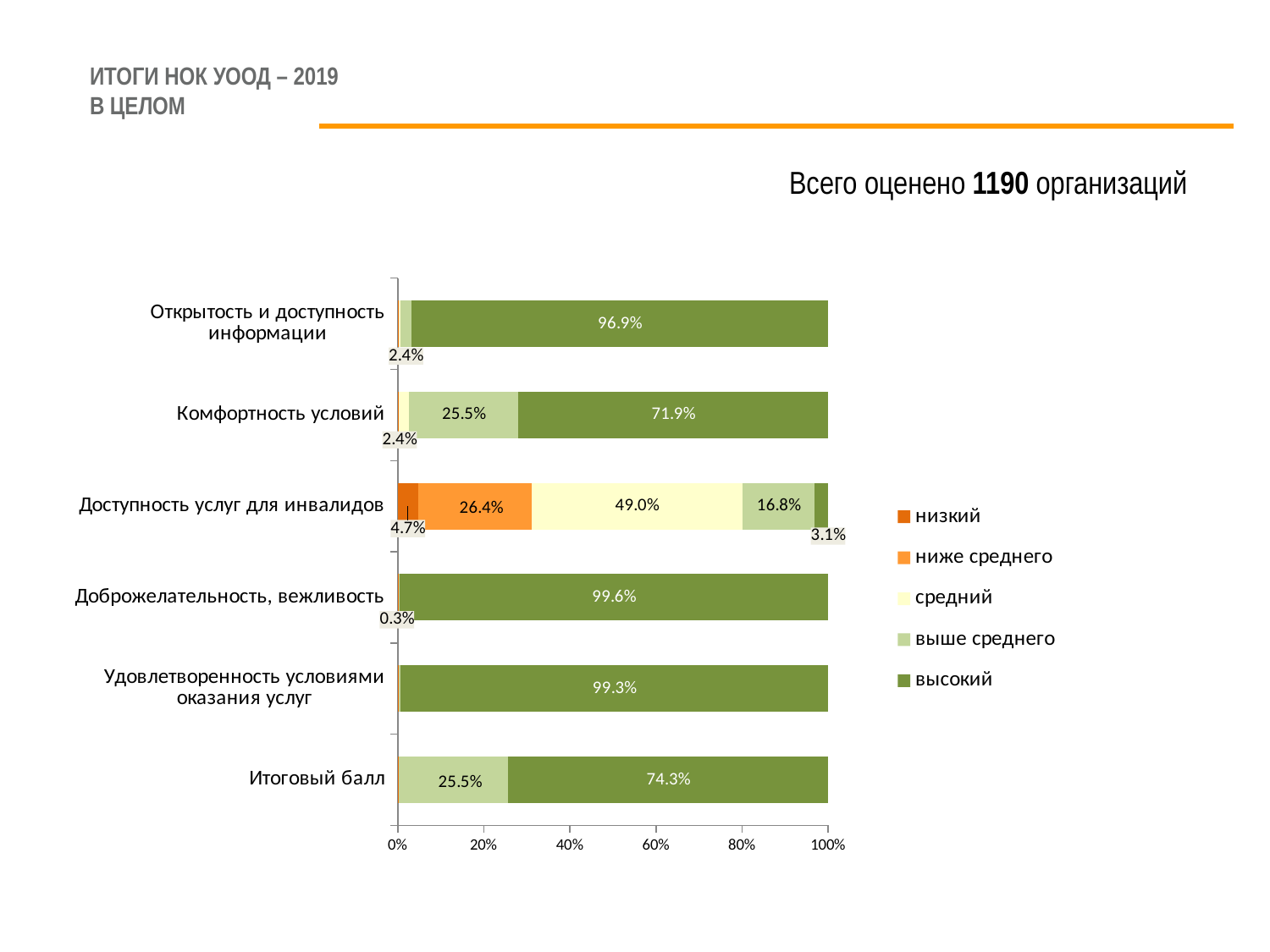
What is the difference between the 'высокий' values for 'Итоговый балл' and 'Комфортность условий'? 2.4 percentage points What is the value of the 'выше среднего' segment for 'Доступность услуг для инвалидов'? 16.8% What is the value of the 'средний' segment for 'Доступность услуг для инвалидов'? 49.0% How many series does the legend list? 5 Which category has the lowest 'высокий' value? Доступность услуг для инвалидов What is the value of the 'ниже среднего' segment for 'Доступность услуг для инвалидов'? 26.4% What is the value of the 'высокий' segment for 'Открытость и доступность информации'? 96.9% What kind of chart is shown on the slide? stacked bar chart What is the value of the 'высокий' segment for 'Итоговый балл'? 74.3% How many categories are plotted on the chart? 6 Which category has the highest 'высокий' value? Доброжелательность, вежливость Which has the larger 'высокий' value: 'Комфортность условий' or 'Итоговый балл'? Итоговый балл